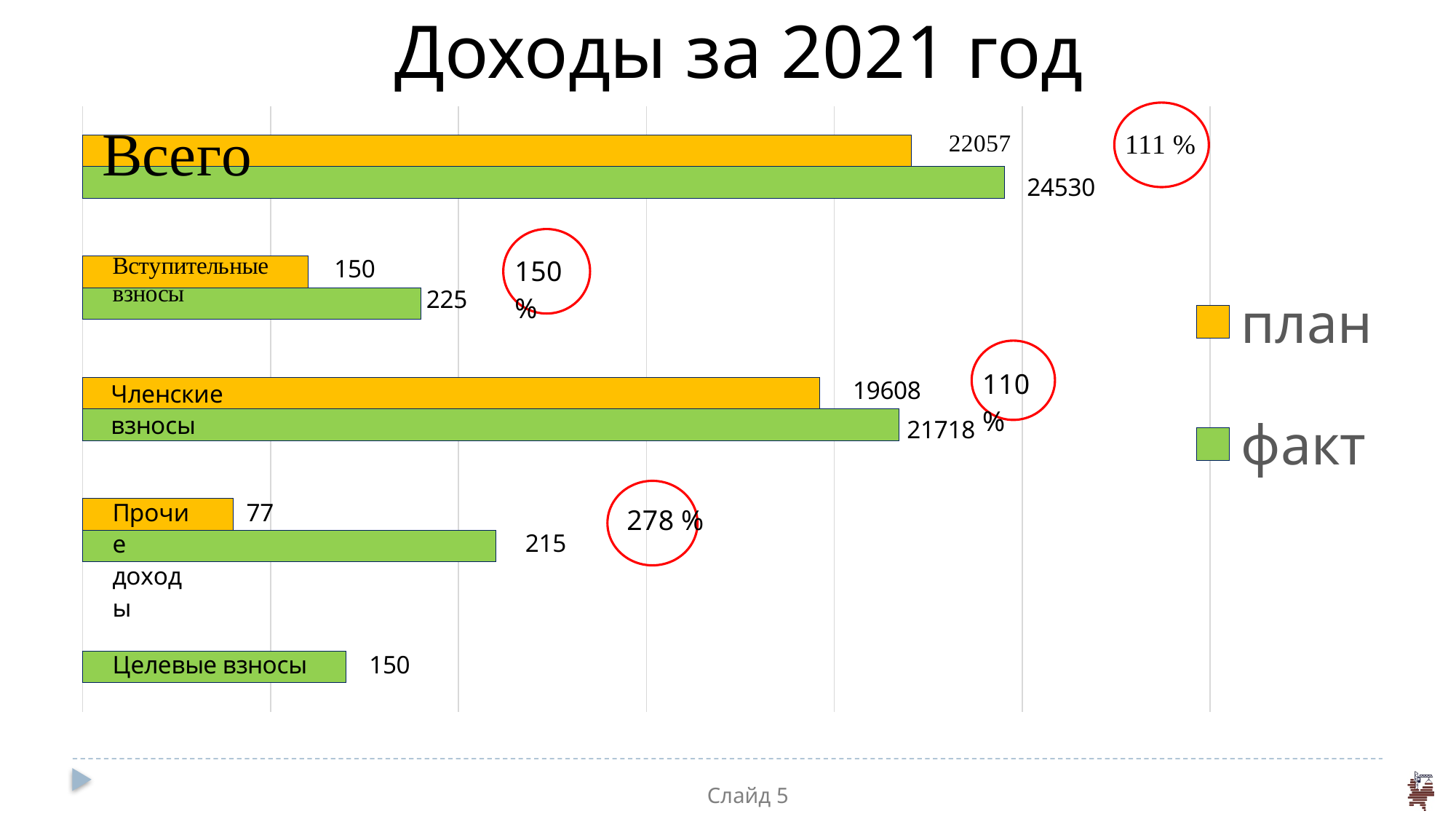
What is the факт value for Всего? 24530 What is the план value for Прочие доходы? 77 Which is larger for Прочие доходы, the план value or the факт value? факт What is the план value for Всего? 22057 What colour represents the факт series in the legend? green What is the факт value for Целевые взносы? 150 How many series does the legend list? 2 What is the факт value for Членские взносы? 21718 Which category has the lowest план value? Прочие доходы What is the difference between the факт and план values for Членские взносы? 2110 What kind of chart is shown on the slide? bar chart What is the difference between the факт and план values for Вступительные взносы? 75